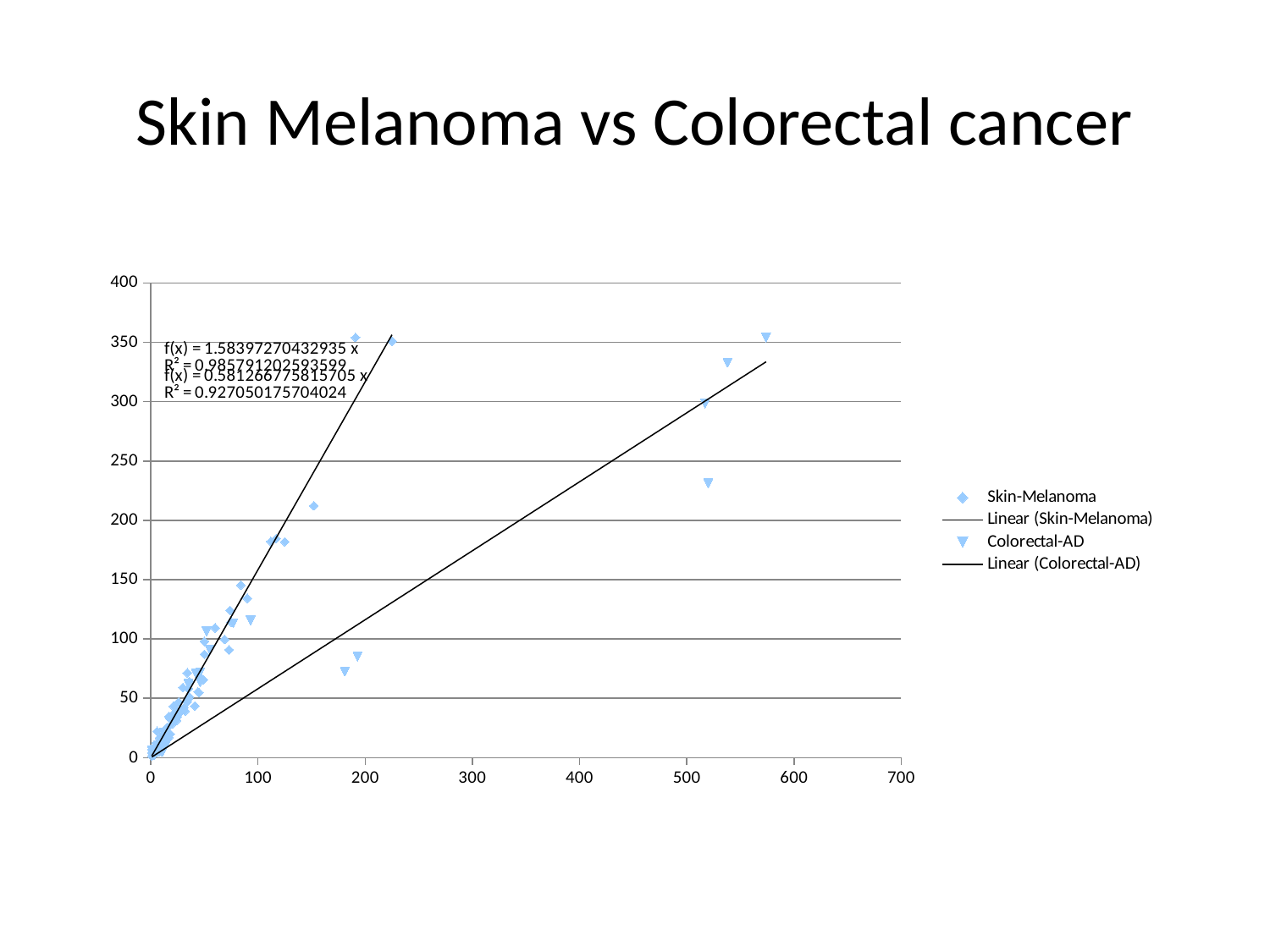
What is the slope of the steeper trendline, as printed in its equation? 1.58397270432935 Do the y values of both series rise or fall as x increases? rise How many entries does the chart legend list? 4 Which series has points extending to the largest x values? Colorectal-AD What kind of chart is shown on the slide? scatter chart What is the slope of the shallower trendline, as printed in its equation? 0.581266775815705 What R² value is printed for the trendline with slope 0.581266775815705? 0.927050175704024 Which two data series are plotted in the chart? Skin-Melanoma and Colorectal-AD Is the largest x value of any Colorectal-AD point greater or less than 500? greater What is the title of the slide? Skin Melanoma vs Colorectal cancer What R² value is printed for the trendline with slope 1.58397270432935? 0.985791202593599 Which series has the steeper linear trendline, Skin-Melanoma or Colorectal-AD? Skin-Melanoma